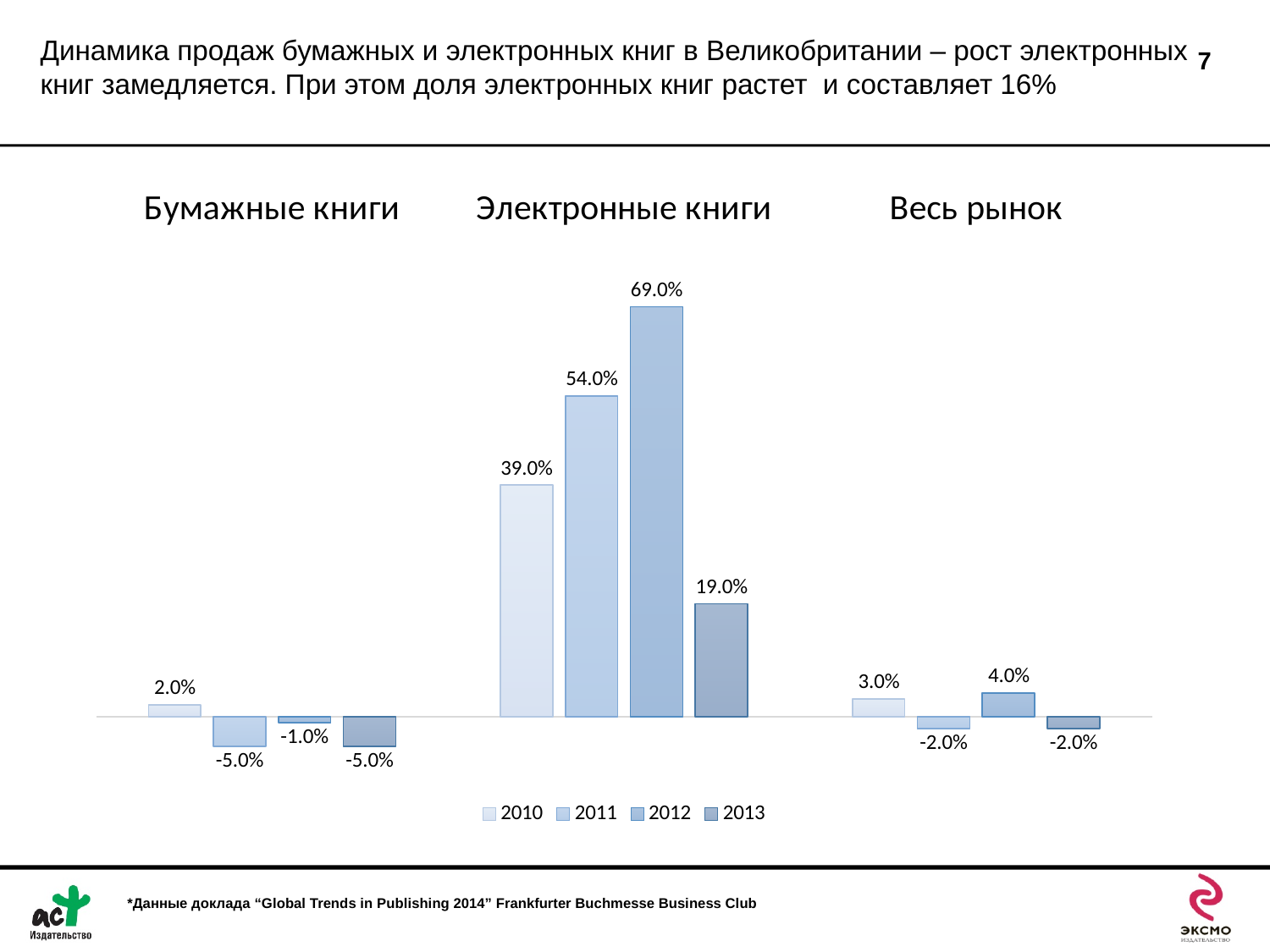
What is the difference between the Электронные книги values for 2012 and 2013? 50.0% What kind of chart is shown on the slide? Bar chart What is the value for Электронные книги in 2013? 19.0% Which is larger for Весь рынок: the 2010 value or the 2012 value? 2012 What is the value for Электронные книги in 2012? 69.0% What is the value for Весь рынок in 2012? 4.0% What is the value for Бумажные книги in 2011? -5.0% How many series does the legend list? 4 How many category groups are shown on the chart? 3 Which year has the highest value for Электронные книги? 2012 What is the difference between the Электронные книги values for 2011 and 2010? 15.0% Which year has the lowest value for Электронные книги? 2013